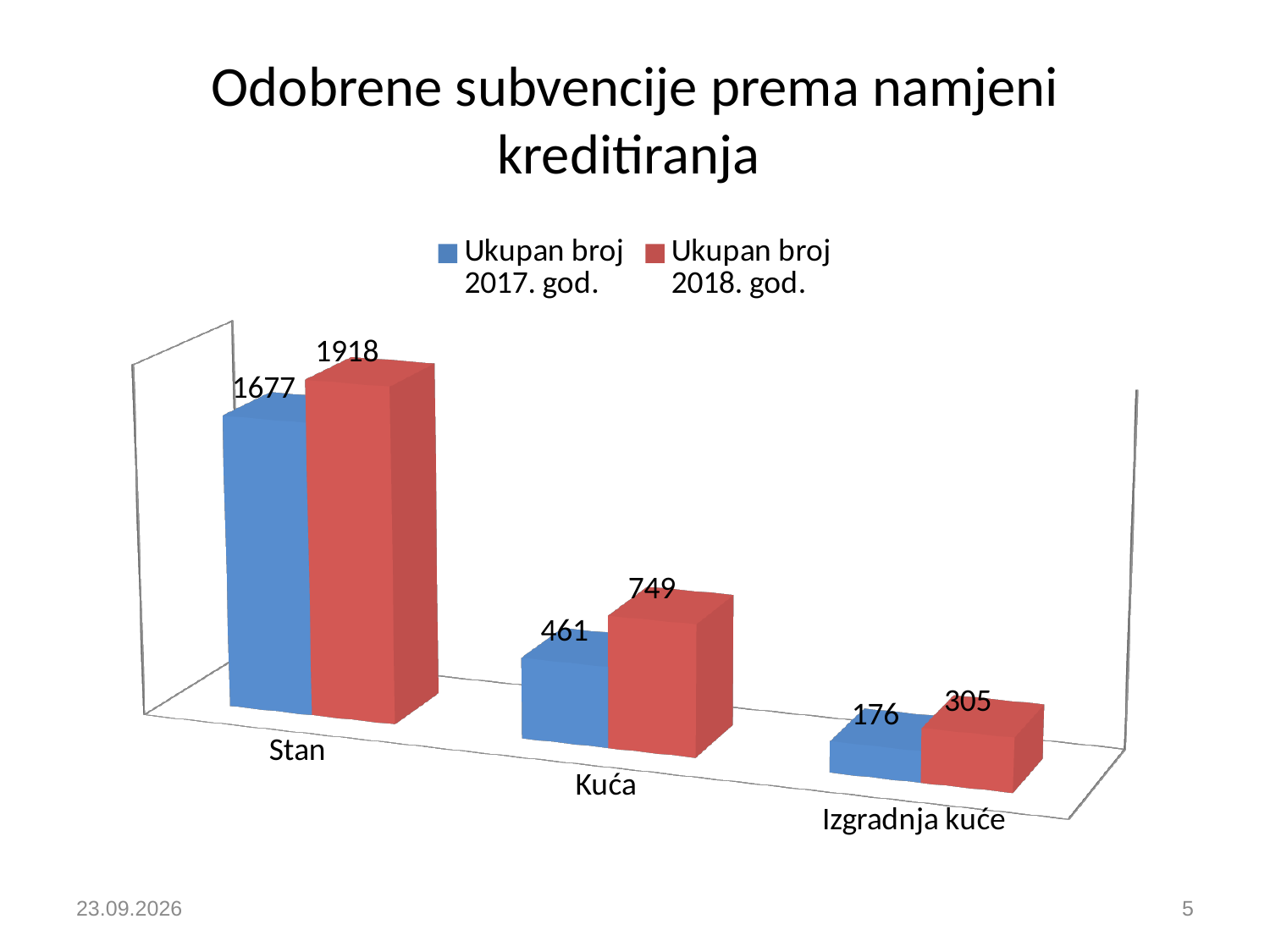
What is the difference between the 2018 and 2017 values for Kuća? 288 Which category has the highest value in the Ukupan broj 2018. god. series? Stan How many categories are shown on the x axis? 3 What is the value for Stan in the Ukupan broj 2017. god. series? 1677 Which is larger for Izgradnja kuće: the Ukupan broj 2017. god. value or the Ukupan broj 2018. god. value? Ukupan broj 2018. god. What is the value for Kuća in the Ukupan broj 2018. god. series? 749 What is the difference between the 2018 and 2017 values for Stan? 241 What is the title of the chart on the slide? Odobrene subvencije prema namjeni kreditiranja What is the value for Izgradnja kuće in the Ukupan broj 2017. god. series? 176 What kind of chart is shown on the slide? Bar chart How many series does the legend list? 2 Which category has the lowest value in the Ukupan broj 2017. god. series? Izgradnja kuće